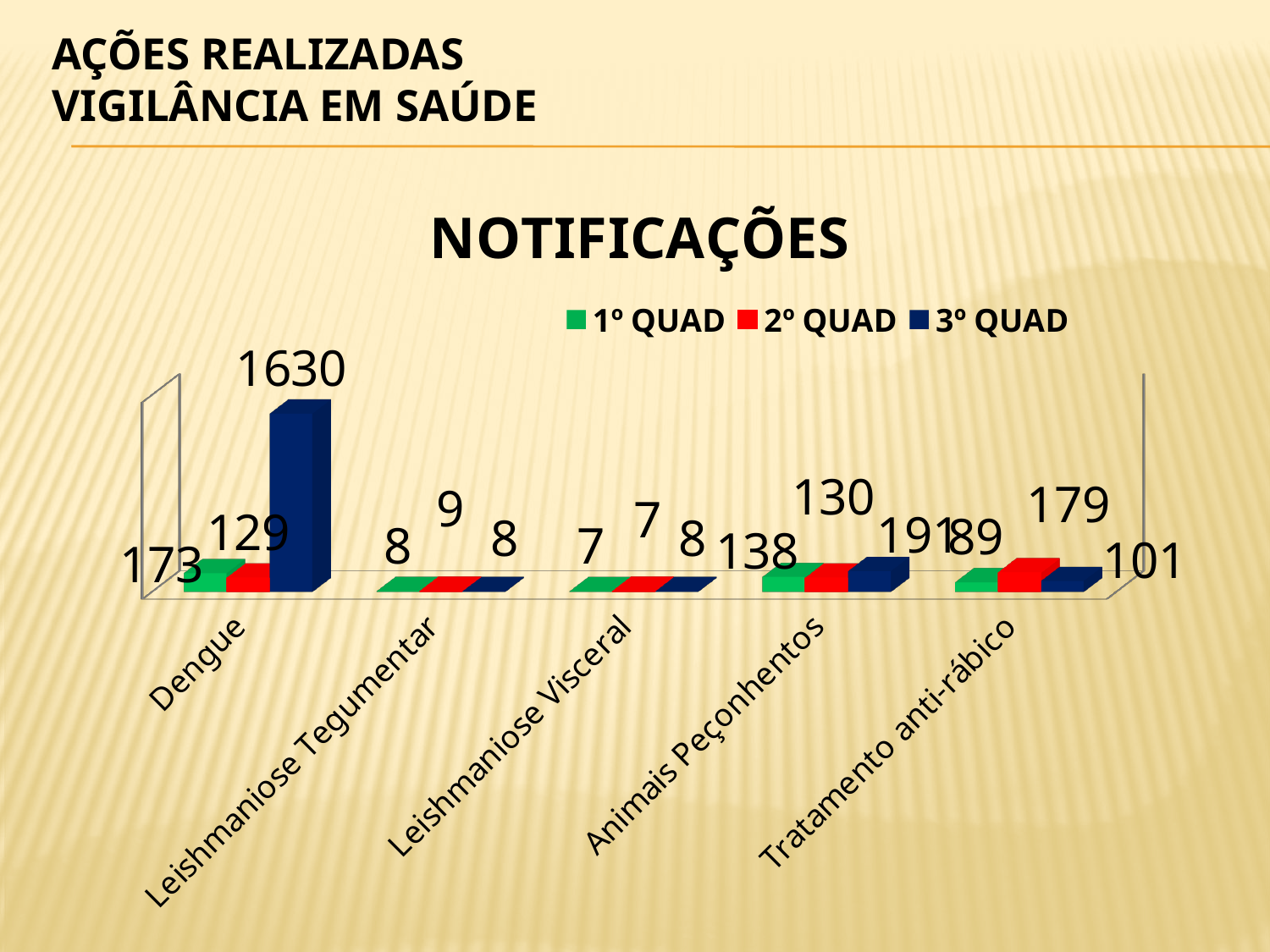
What is the value for Leishmaniose Tegumentar in the 2º QUAD series? 9 What is the value for Animais Peçonhentos in the 1º QUAD series? 138 Which category has the highest value in the 3º QUAD series? Dengue How many categories are shown on the x axis of the NOTIFICAÇÕES chart? 5 What is the value for Dengue in the 1º QUAD series? 173 For Tratamento anti-rábico, which is larger: the 2º QUAD value or the 3º QUAD value? 2º QUAD What kind of chart is shown on the slide? bar chart What is the value for Dengue in the 3º QUAD series? 1630 How many series does the legend of the NOTIFICAÇÕES chart list? 3 What is the value for Tratamento anti-rábico in the 3º QUAD series? 101 What colour represents the 3º QUAD series in the legend? blue What is the difference between the 1º QUAD and 2º QUAD values for Dengue? 44